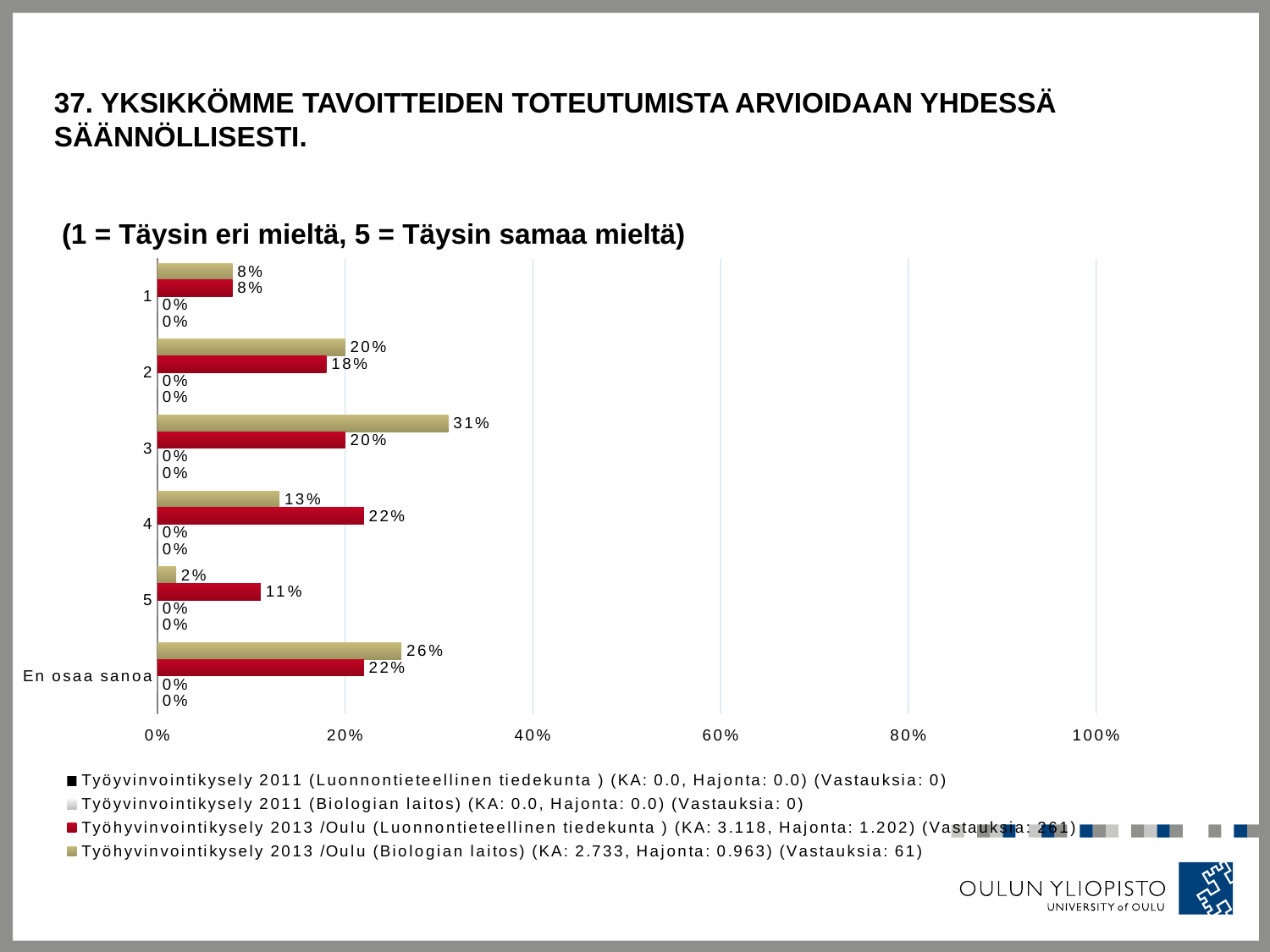
What is the difference between the Biologian laitos 2013 value and the Luonnontieteellinen tiedekunta 2013 value for category 3? 11% What is the value for category 3 in the Työhyvinvointikysely 2013 /Oulu (Biologian laitos) series? 31% What is the value for category 4 in the Työhyvinvointikysely 2013 /Oulu (Luonnontieteellinen tiedekunta) series? 22% What is the value for category 5 in the Työhyvinvointikysely 2013 /Oulu (Biologian laitos) series? 2% Which category has the lowest value in the Työhyvinvointikysely 2013 /Oulu (Luonnontieteellinen tiedekunta) series? 1 How many responses (Vastauksia) does the legend give for Työhyvinvointikysely 2013 /Oulu (Luonnontieteellinen tiedekunta)? 261 What is the value for En osaa sanoa in the Työhyvinvointikysely 2013 /Oulu (Biologian laitos) series? 26% For category 4, which 2013 series has the larger value: Luonnontieteellinen tiedekunta or Biologian laitos? Luonnontieteellinen tiedekunta What kind of chart is shown on the slide? bar chart How many categories are shown on the vertical axis? 6 Which category has the highest value in the Työhyvinvointikysely 2013 /Oulu (Biologian laitos) series? 3 How many series does the legend list? 4